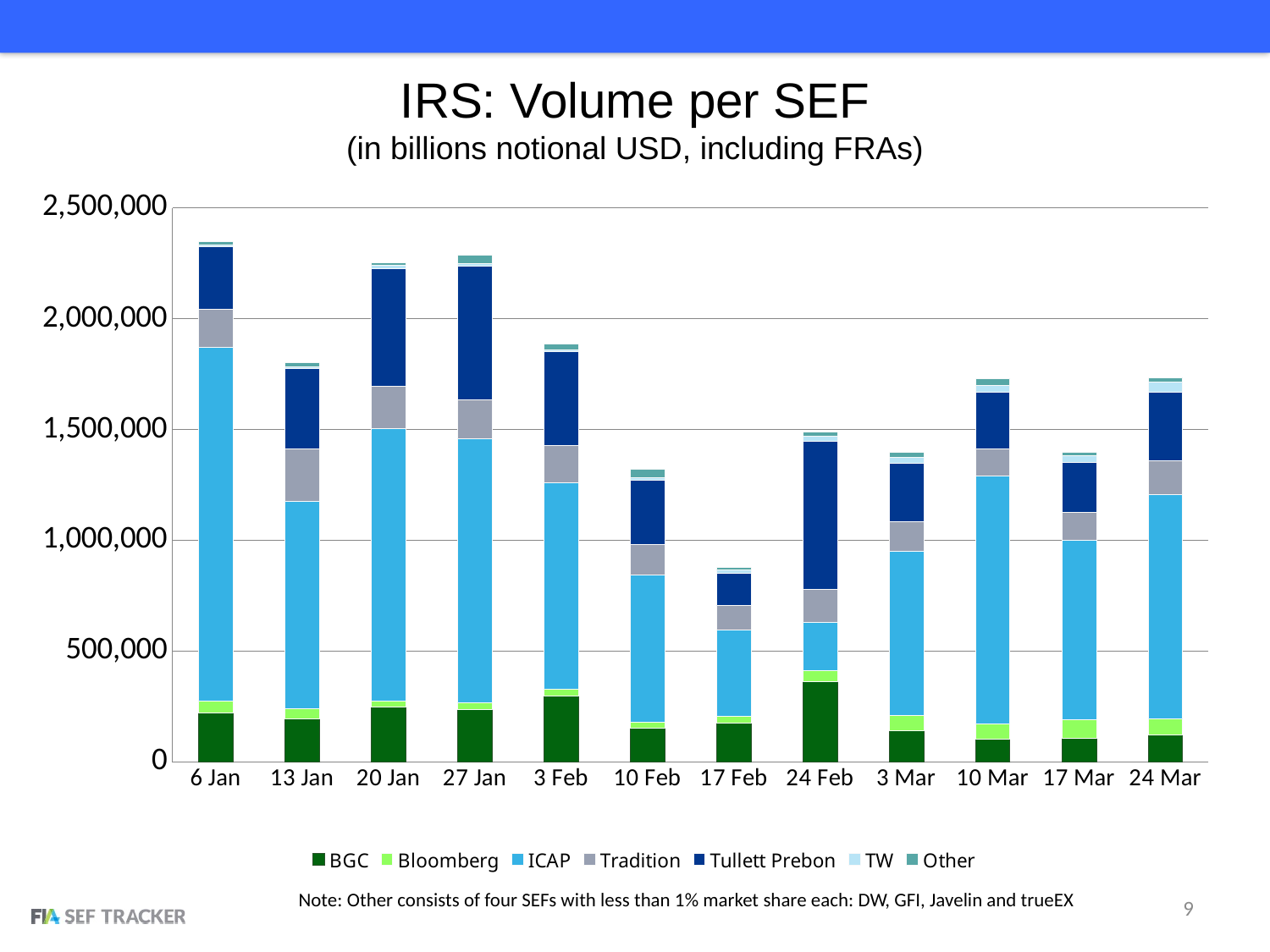
Is the total bar for 3 Feb greater or less than 2,000,000? less How many series does the chart's legend list? 7 Which date has the lowest total volume bar? 17 Feb Which date has the highest total volume bar? 6 Jan How many weekly dates are shown along the x axis of the chart? 12 From 27 Jan to 17 Feb, do the total bar heights rise or fall? fall Is the total bar for 6 Jan greater or less than 2,000,000? greater Which has the larger total bar, 24 Feb or 17 Feb? 24 Feb Is the total bar for 17 Feb greater or less than 1,000,000? less Which has the larger total bar, 6 Jan or 13 Jan? 6 Jan What is the title of the chart? IRS: Volume per SEF What kind of chart is shown on the slide? Stacked bar chart